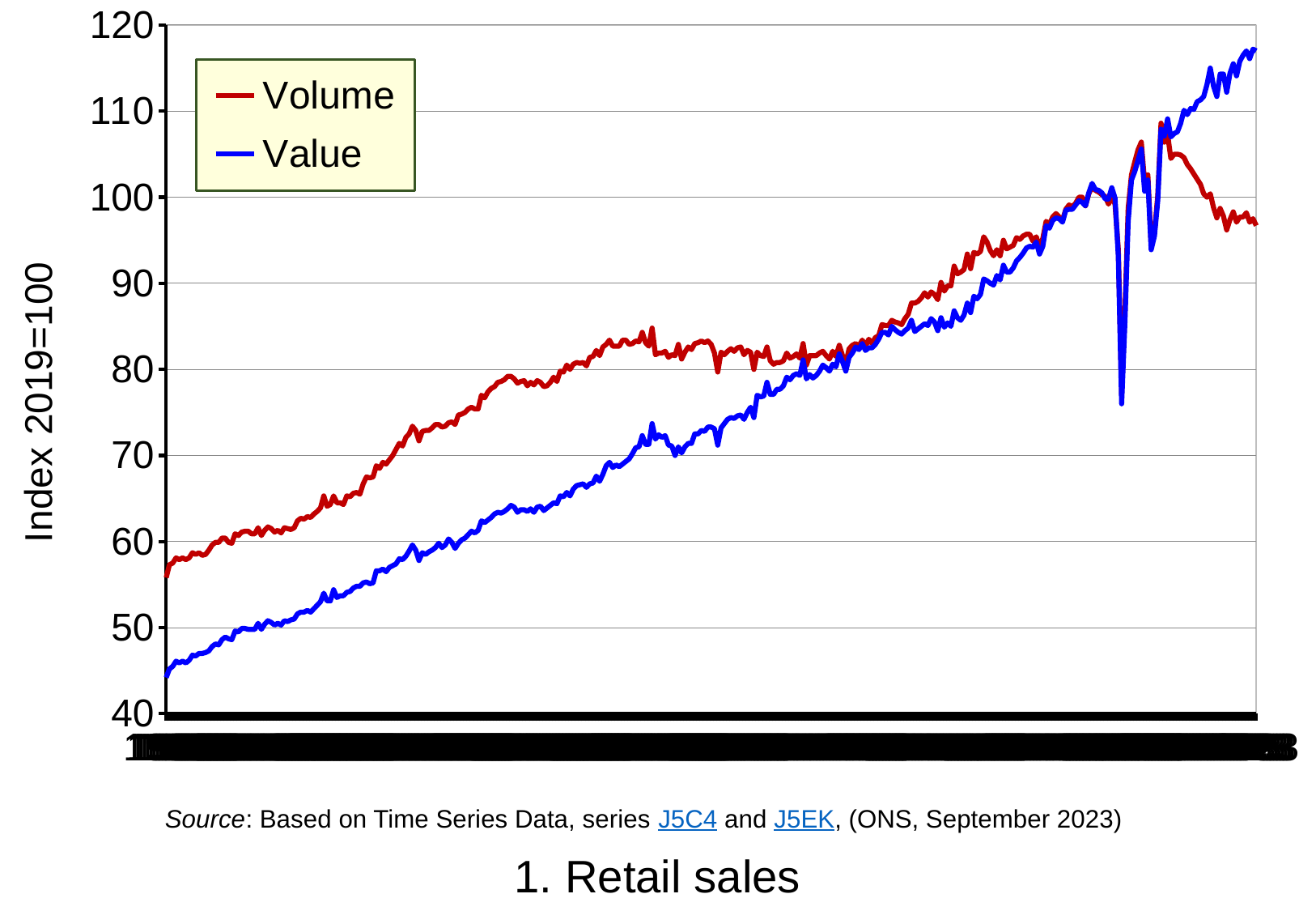
What are the names of the two series in the legend? Volume and Value What is the label on the vertical axis? Index 2019=100 At the left end of the chart, is the Volume series greater or less than 60? less How many series does the legend list? 2 At the left end of the chart, is the Value series greater or less than 50? less Overall, do the Value series values rise or fall along the x axis? rise At the right end of the chart, is the Value series greater or less than 110? greater At the right end of the chart, which series is higher, Volume or Value? Value What kind of chart is shown on the slide? line chart At the left end of the chart, which series is higher, Volume or Value? Volume